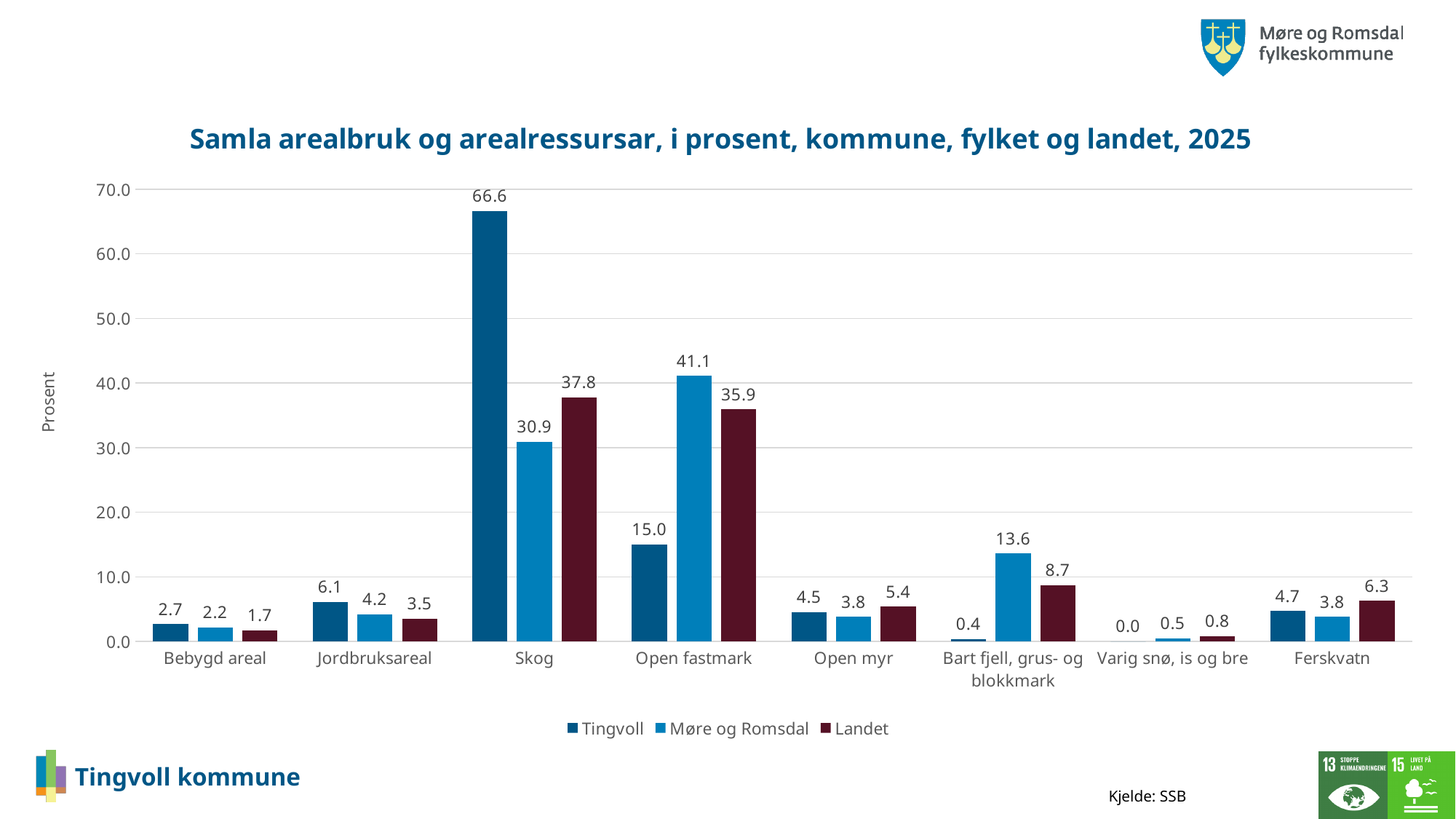
What is the label of the y axis? Prosent What is the value for Landet in the Ferskvatn category? 6.3 Which is larger in the Open fastmark category: Tingvoll or Landet? Landet What is the difference between the Tingvoll and Landet values for Skog? 28.8 Which category has the highest value for Tingvoll? Skog How many categories are shown on the x axis? 8 Is the value for Møre og Romsdal in the Skog category greater or less than 40.0? less What is the value for Tingvoll in the Skog category? 66.6 What is the value for Møre og Romsdal in the Open fastmark category? 41.1 How many series does the legend list? 3 What kind of chart is shown on the slide? Bar chart Which category has the lowest value for Tingvoll? Varig snø, is og bre